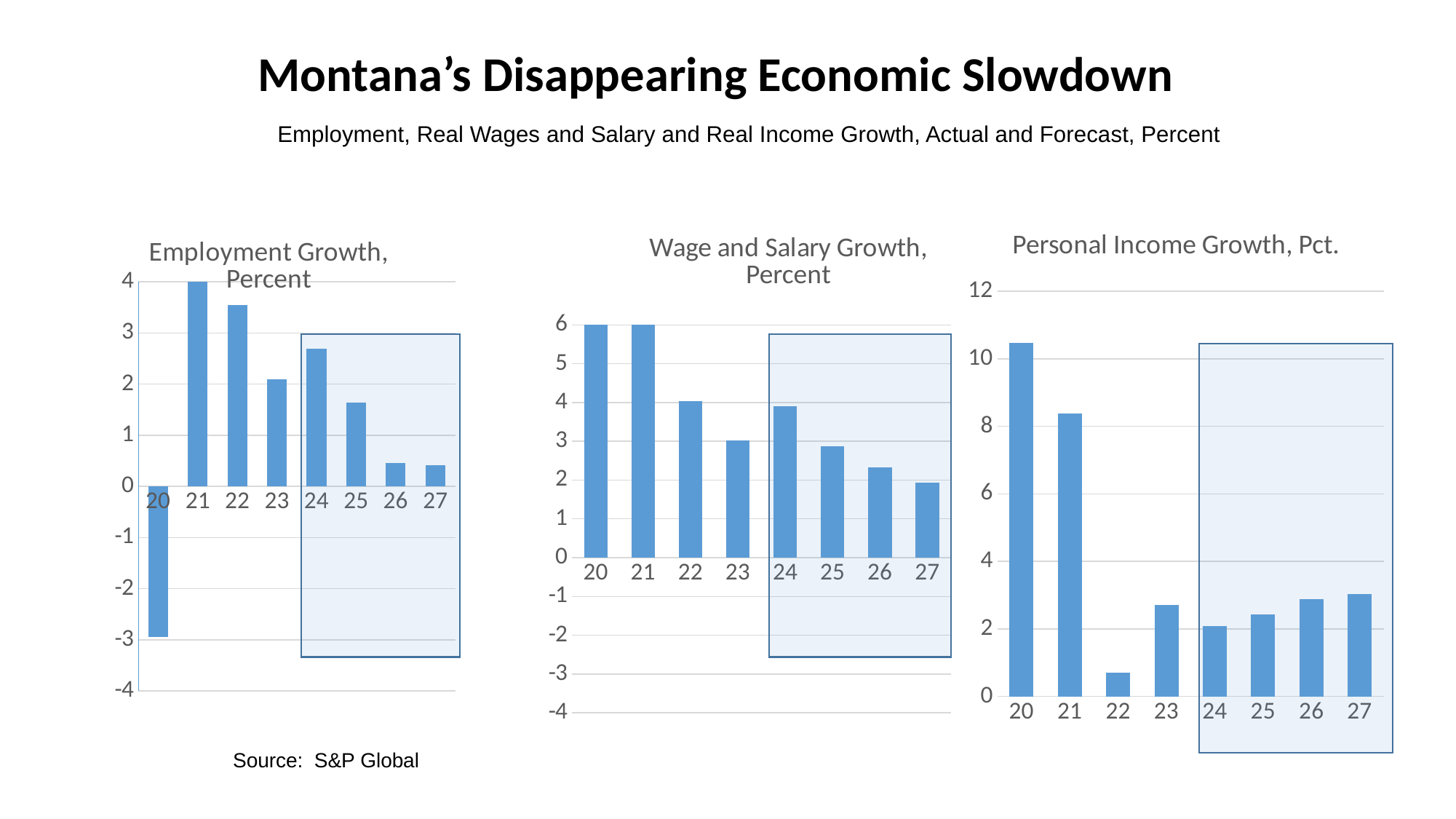
In the Wage and Salary Growth, Percent chart, do the values rise or fall from 22 to 27? fall In the Wage and Salary Growth, Percent chart, which is larger, the value for 22 or the value for 25? 22 In the Employment Growth, Percent chart, is the value for 24 greater or less than 2? greater In the Personal Income Growth, Pct. chart, do the values rise or fall from 24 to 27? rise In the Employment Growth, Percent chart, is the value for 20 greater or less than -2? less In the Employment Growth, Percent chart, which year has the highest value? 21 How many years are shown on the x axis of the Wage and Salary Growth, Percent chart? 8 What type of chart is the Employment Growth, Percent chart? bar chart In the Personal Income Growth, Pct. chart, which year has the lowest value? 22 In the Personal Income Growth, Pct. chart, is the value for 20 greater or less than 10? greater In the Employment Growth, Percent chart, which year has the lowest value? 20